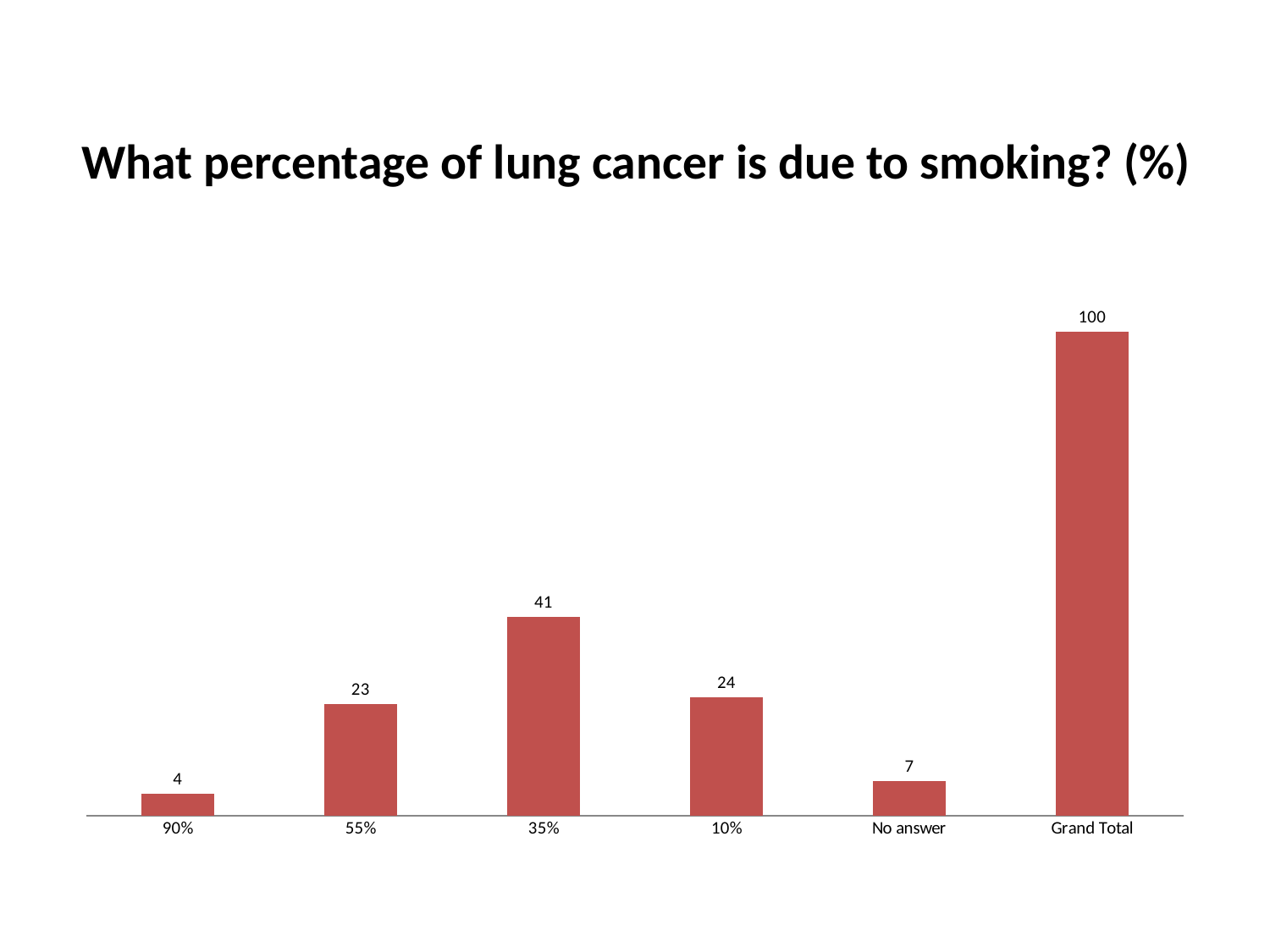
What is the difference between the values for 55% and 90%? 19 What is the title of the chart? What percentage of lung cancer is due to smoking? (%) How many categories are shown on the x axis? 6 Which category has the lowest value? 90% Excluding Grand Total, which category has the highest value? 35% What is the value for Grand Total? 100 What is the value for the 35% category? 41 What kind of chart is shown on the slide? Bar chart Which is larger, the value for 55% or the value for 10%? 10% What is the difference between the values for 35% and 10%? 17 What is the value for the 90% category? 4 What is the value for No answer? 7